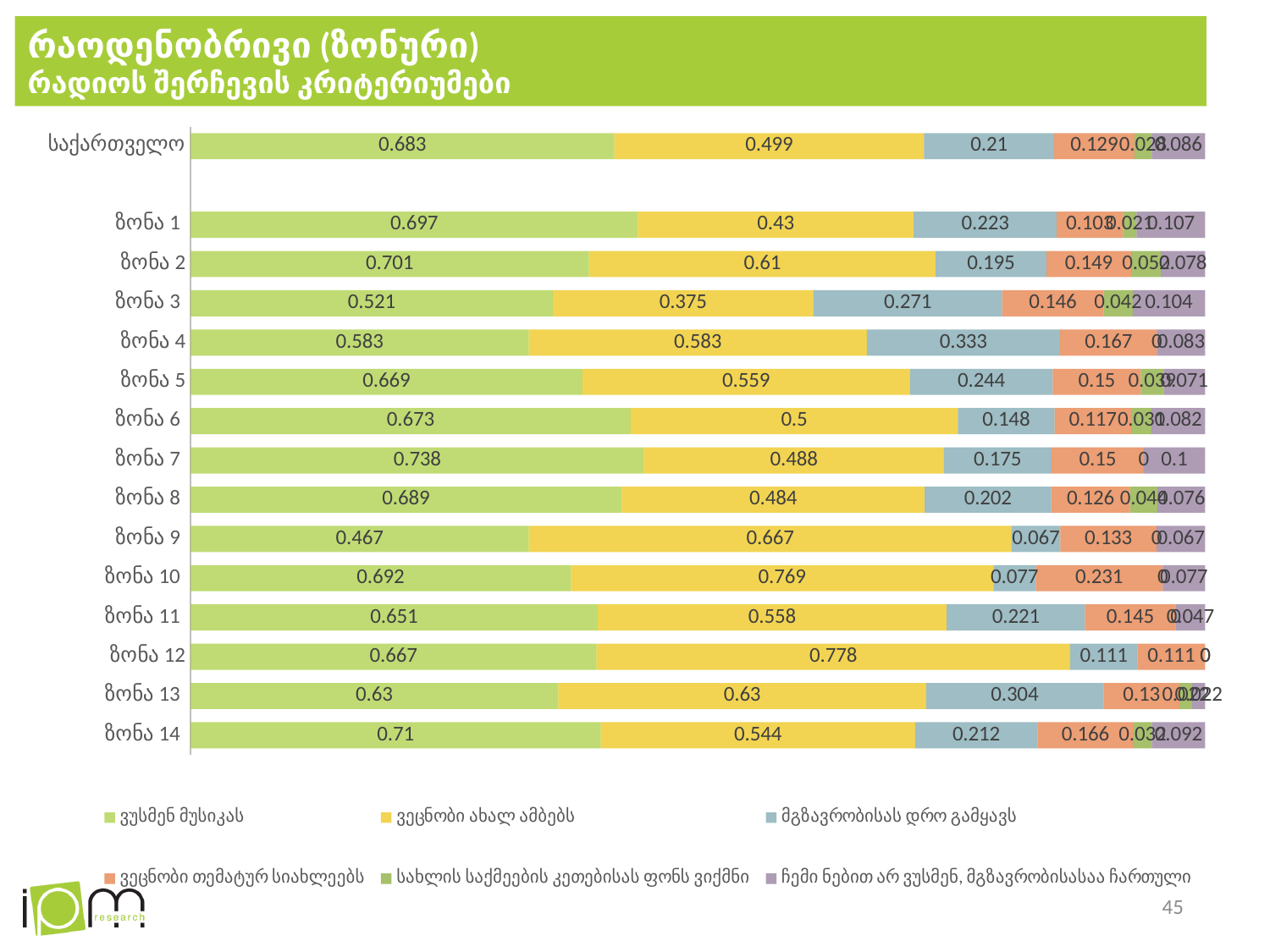
What is the value of the ვეცნობი ახალ ამბებს series for ზონა 12? 0.778 Which series is shown in yellow in the chart? ვეცნობი ახალ ამბებს What is the value of the ვუსმენ მუსიკას series for ზონა 7? 0.738 Which category has the highest value for the ვუსმენ მუსიკას series? ზონა 7 What is the difference between the ვუსმენ მუსიკას values for ზონა 7 and ზონა 9? 0.271 What kind of chart is shown on the slide? Stacked bar chart Which category has the highest value for the მგზავრობისას დრო გამყავს series? ზონა 4 How many series does the legend list? 6 How many categories (rows) are plotted in the chart? 15 Which category has the lowest value for the ვუსმენ მუსიკას series? ზონა 9 What is the value of the მგზავრობისას დრო გამყავს series for საქართველო? 0.21 Which has the larger ვუსმენ მუსიკას value, ზონა 2 or ზონა 3? ზონა 2